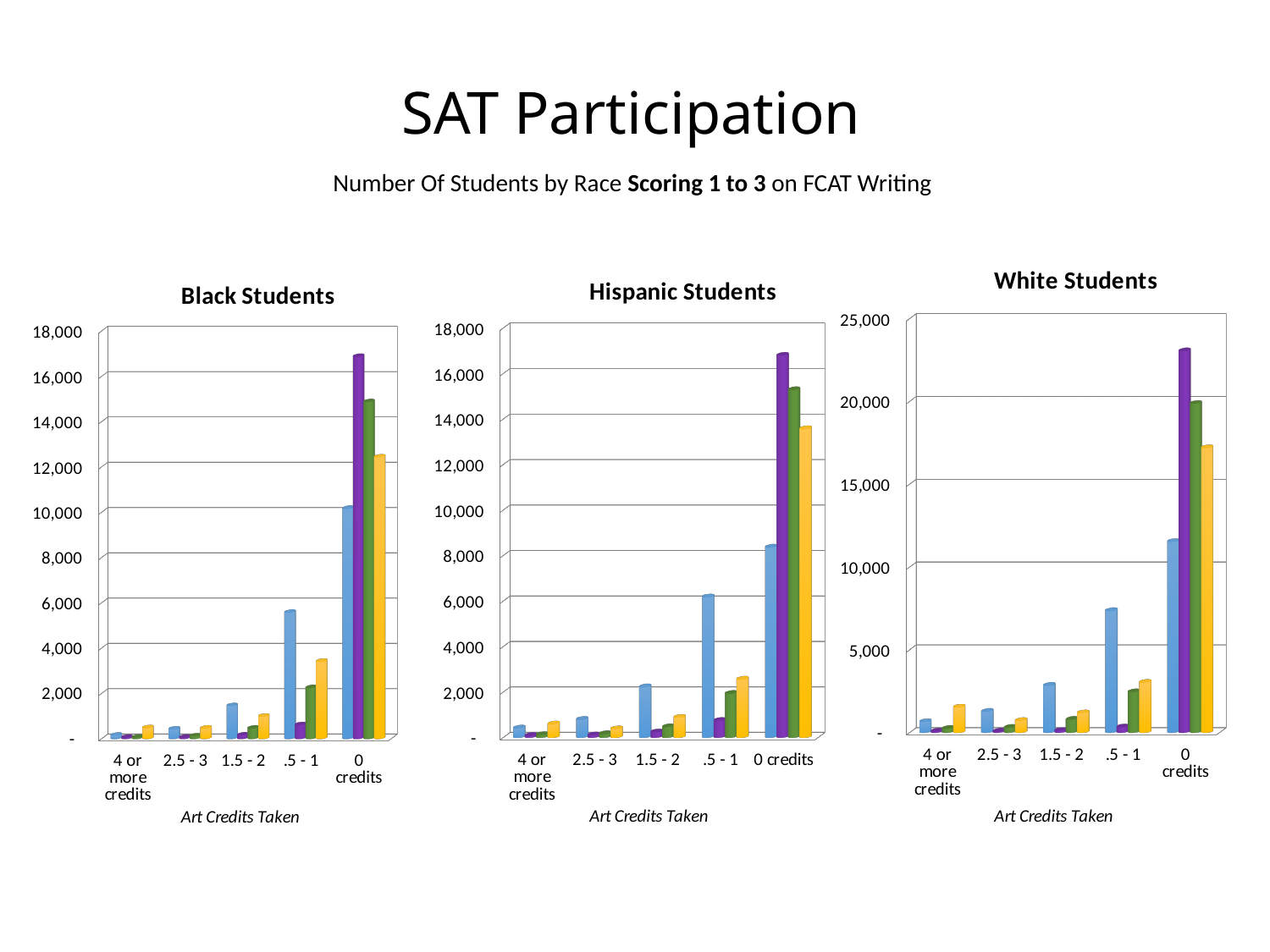
In the White Students chart, is the blue bar for .5 - 1 credits greater or less than 10,000? less In the White Students chart, which art-credit category has the tallest bars? 0 credits In the Black Students chart, is the blue bar for .5 - 1 credits greater or less than 6,000? less In the Hispanic Students chart, for 0 credits, which is larger: the blue bar or the purple bar? the purple bar In the Black Students chart, do the bar heights generally rise or fall moving from left (4 or more credits) to right (0 credits) along the x axis? rise In the Black Students chart, is the tallest bar for 0 credits greater or less than 16,000? greater How many art-credit categories are shown on the x axis of the Hispanic Students chart? 5 What is the x-axis label shown under each of the three charts? Art Credits Taken What kind of chart is the Black Students chart? bar chart In the Black Students chart, which art-credit category has the tallest bars? 0 credits